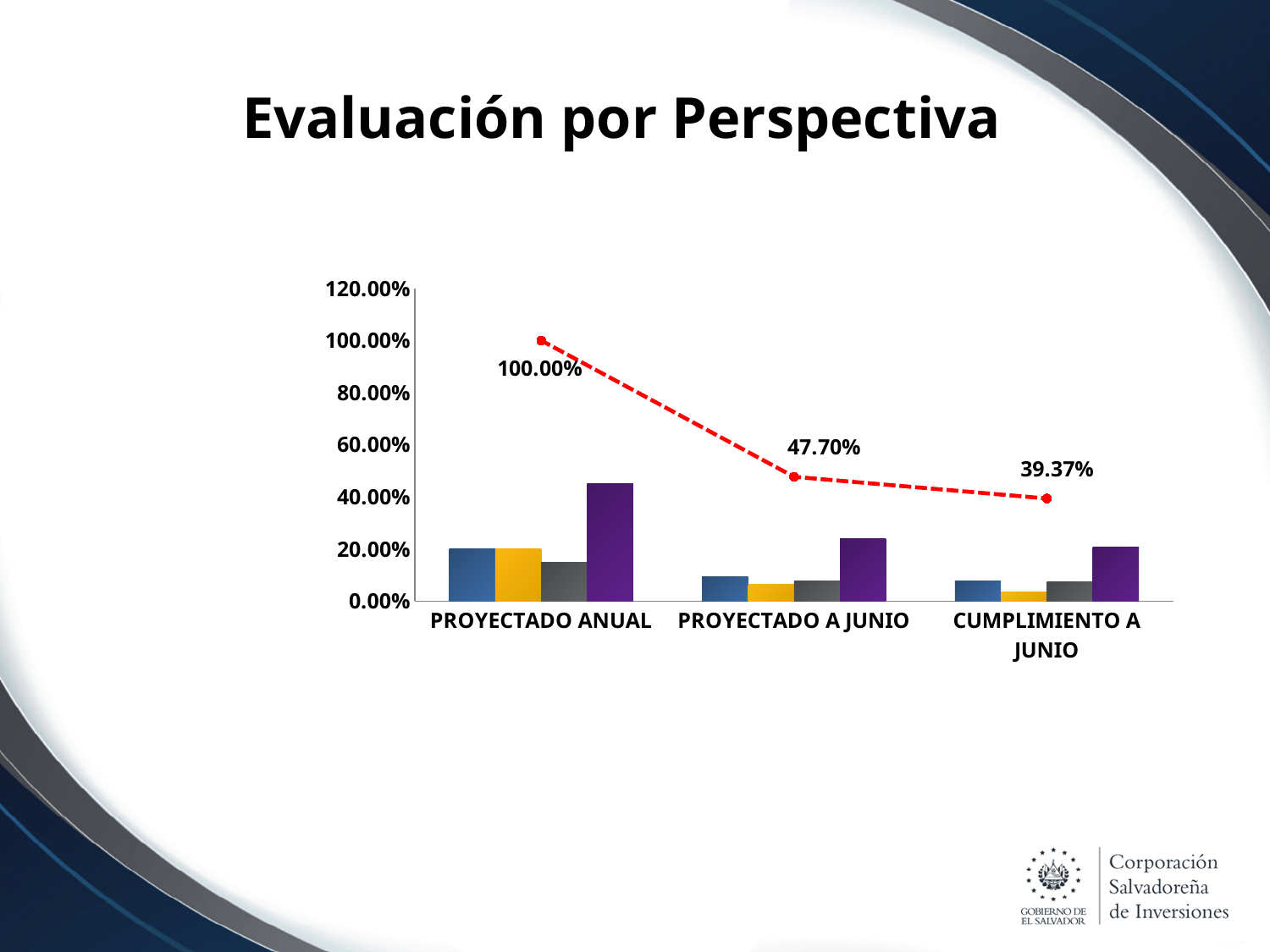
What value does the red dashed line show for PROYECTADO A JUNIO? 47.70% What is the difference between the line values for PROYECTADO A JUNIO and CUMPLIMIENTO A JUNIO? 8.33% What value does the red dashed line show for CUMPLIMIENTO A JUNIO? 39.37% What is the title of the slide containing the chart? Evaluación por Perspectiva Which category has the highest value on the red dashed line? PROYECTADO ANUAL Is the purple bar for PROYECTADO ANUAL greater or less than 60.00%? less What value does the red dashed line show for PROYECTADO ANUAL? 100.00% How many categories are shown on the x axis? 3 Which category has the lowest value on the red dashed line? CUMPLIMIENTO A JUNIO Does the red dashed line rise or fall from left to right across the categories? It falls Which is larger, the line value for PROYECTADO A JUNIO or for CUMPLIMIENTO A JUNIO? PROYECTADO A JUNIO What is the difference between the line values for PROYECTADO ANUAL and PROYECTADO A JUNIO? 52.30%